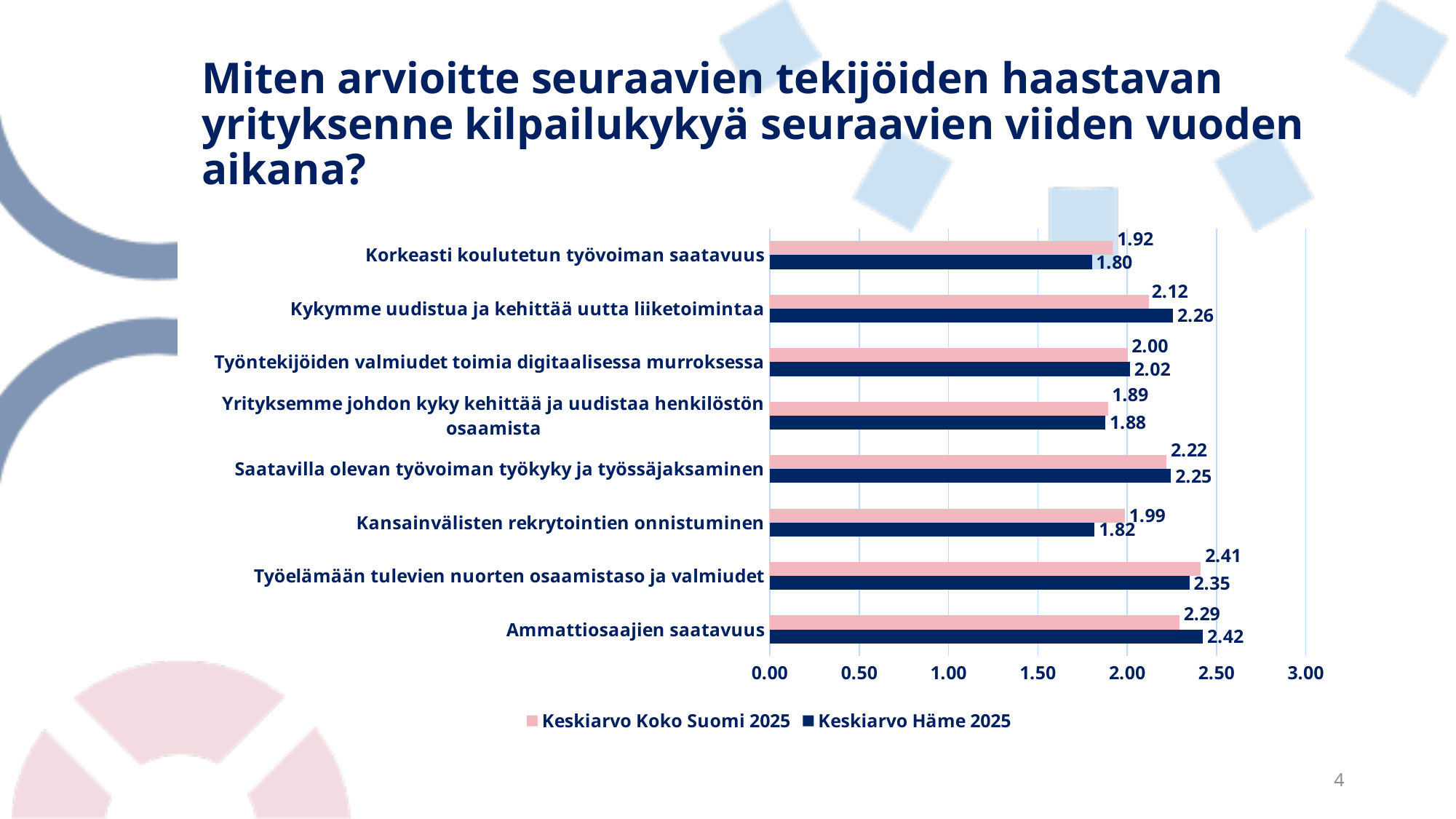
How many categories are shown in the chart? 8 What is the Keskiarvo Koko Suomi 2025 value for Ammattiosaajien saatavuus? 2.29 What is the difference between the Keskiarvo Koko Suomi 2025 and Keskiarvo Häme 2025 values for Kansainvälisten rekrytointien onnistuminen? 0.17 How many series does the legend list? 2 Which category has the highest Keskiarvo Koko Suomi 2025 value? Työelämään tulevien nuorten osaamistaso ja valmiudet Which category has the highest Keskiarvo Häme 2025 value? Ammattiosaajien saatavuus What is the difference between the Keskiarvo Häme 2025 and Keskiarvo Koko Suomi 2025 values for Ammattiosaajien saatavuus? 0.13 What is the Keskiarvo Häme 2025 value for Kansainvälisten rekrytointien onnistuminen? 1.82 Which category has the lowest Keskiarvo Häme 2025 value? Korkeasti koulutetun työvoiman saatavuus What is the Keskiarvo Häme 2025 value for Kykymme uudistua ja kehittää uutta liiketoimintaa? 2.26 For Korkeasti koulutetun työvoiman saatavuus, which series has the larger value: Keskiarvo Koko Suomi 2025 or Keskiarvo Häme 2025? Keskiarvo Koko Suomi 2025 What kind of chart is shown on the slide? Bar chart